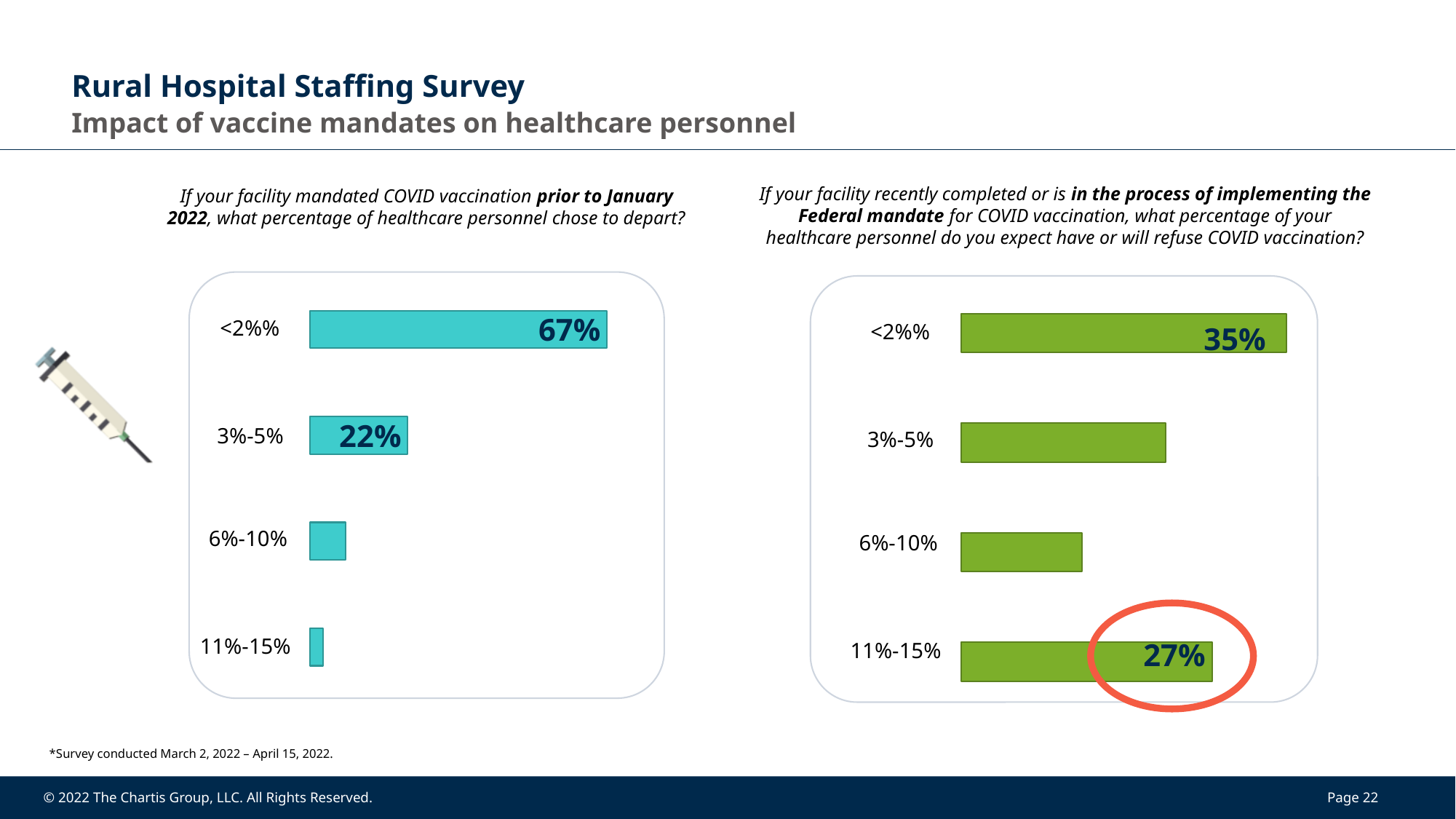
In the left chart (departures prior to January 2022), what percentage of respondents chose the <2%% category? 67% In the right chart (Federal mandate refusal), what is the value for the 11%-15% category? 27% In the left chart (departures prior to January 2022), what is the value for the 3%-5% category? 22% In the left chart (departures prior to January 2022), which category has the highest value? <2%% What type of chart is used on the right (Federal mandate refusal)? Bar chart In the right chart (Federal mandate refusal), which is larger: the value for 3%-5% or the value for 6%-10%? 3%-5% How many categories are shown in the left chart (departures prior to January 2022)? 4 In the right chart (Federal mandate refusal), which category has the lowest value? 6%-10% In the right chart (Federal mandate refusal), which category has the highest value? <2%% In the left chart (departures prior to January 2022), what is the difference between the <2%% and 3%-5% values? 45 percentage points In the right chart (Federal mandate refusal), what is the value for the <2%% category? 35% In the left chart (departures prior to January 2022), which category has the lowest value? 11%-15%